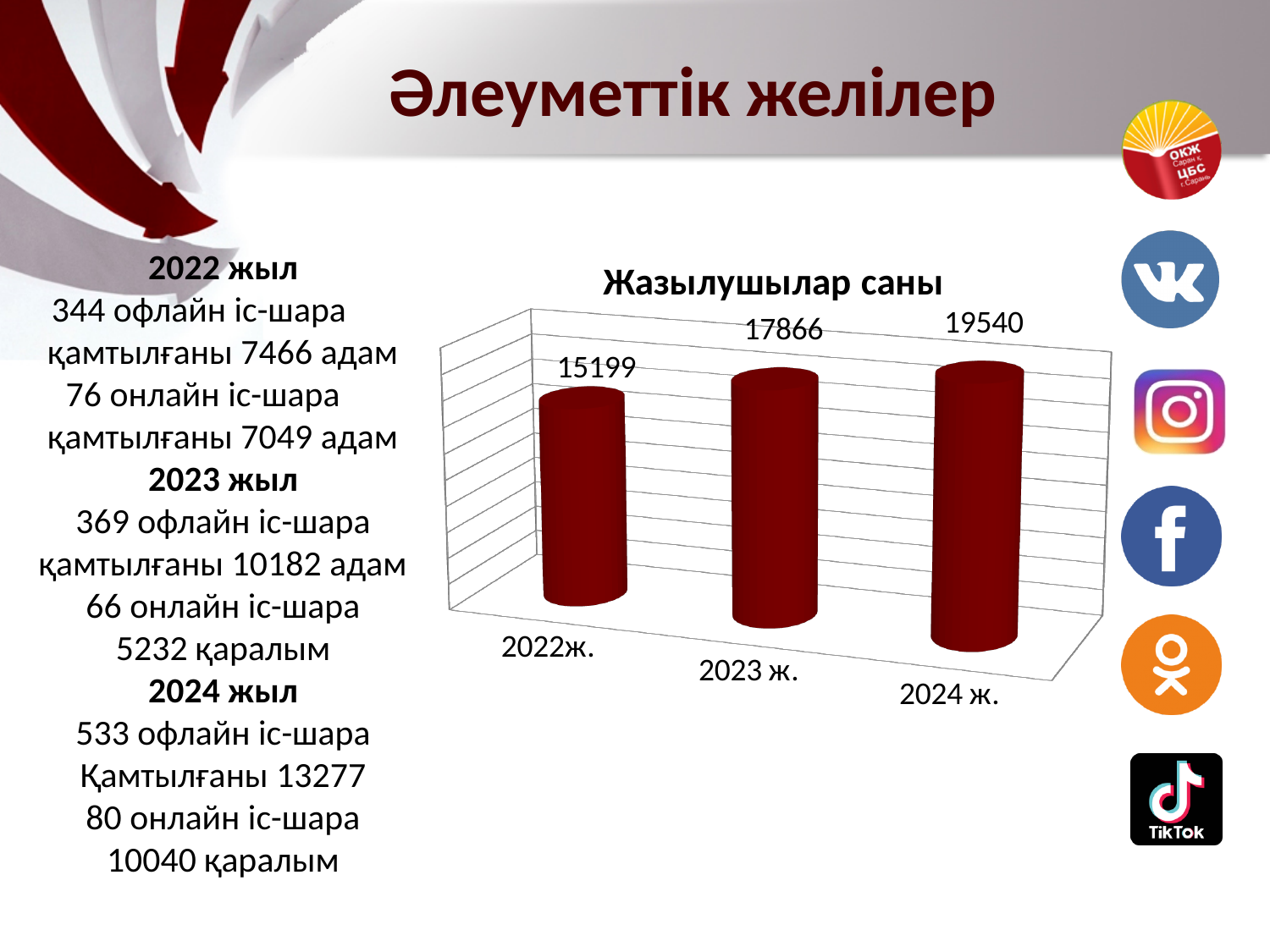
What is the value for 2023 ж. in the chart? 17866 Do the values rise or fall from 2022ж. to 2024 ж.? rise Which year has the highest value in the chart? 2024 ж. What is the value for 2022ж. in the chart? 15199 What is the difference between the values for 2024 ж. and 2023 ж.? 1674 Which year has the lowest value in the chart? 2022ж. Which is larger, the value for 2023 ж. or the value for 2024 ж.? 2024 ж. What is the value for 2024 ж. in the chart? 19540 What is the difference between the values for 2024 ж. and 2022ж.? 4341 How many categories are shown in the chart? 3 What is the difference between the values for 2023 ж. and 2022ж.? 2667 What kind of chart is shown on the slide? bar chart